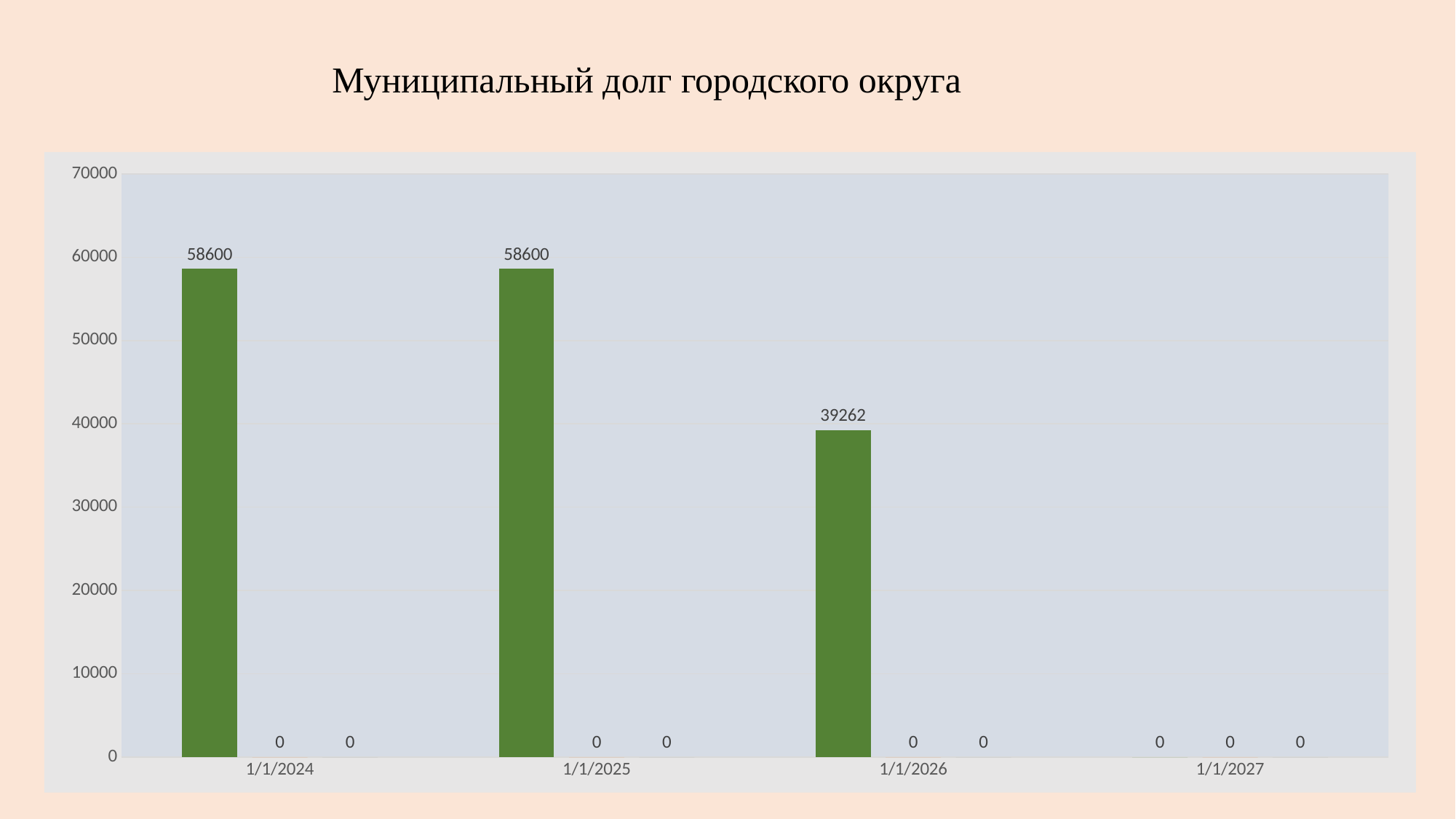
What value is shown for the green series at 1/1/2027? 0 What is the value of the green bar for 1/1/2024? 58600 Is the value of the green bar for 1/1/2026 greater or less than 40000? less How many date categories are shown on the x axis? 4 Which category has the lowest value for the green series? 1/1/2027 Which is larger, the green bar for 1/1/2024 or the green bar for 1/1/2026? 1/1/2024 Is the value of the green bar for 1/1/2024 greater or less than 50000? greater Do the green bar values rise or fall from 1/1/2025 to 1/1/2027? fall What is the value of the green bar for 1/1/2025? 58600 What is the value of the green bar for 1/1/2026? 39262 What kind of chart is shown on the slide? bar chart What is the difference between the green bar values for 1/1/2025 and 1/1/2026? 19338